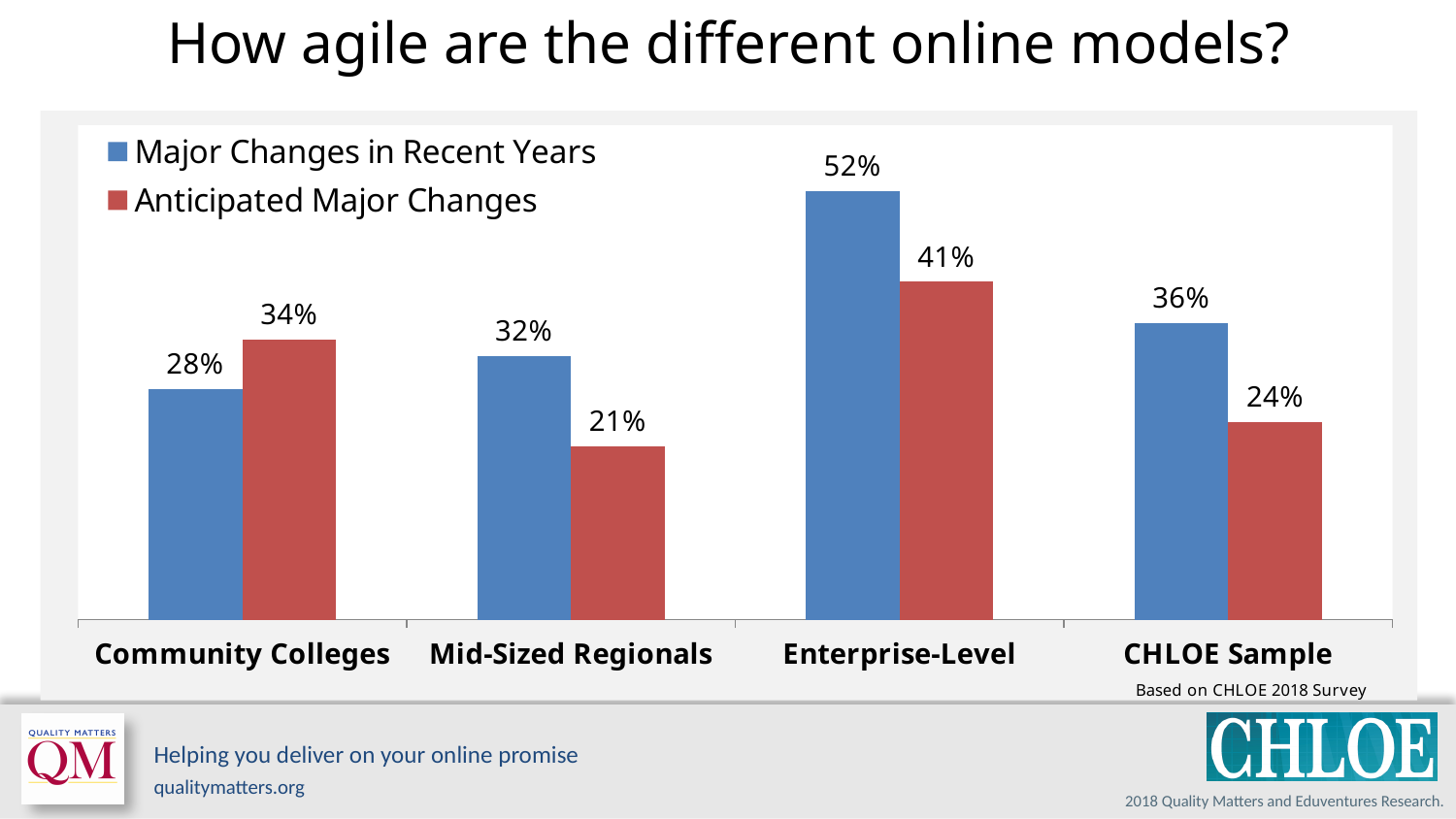
What is the value for Major Changes in Recent Years for Community Colleges? 28% How many series does the legend list? 2 Which category has the lowest value for Anticipated Major Changes? Mid-Sized Regionals What is the value for Anticipated Major Changes for Mid-Sized Regionals? 21% What is the value for Anticipated Major Changes for Enterprise-Level? 41% Which is larger for Community Colleges: Major Changes in Recent Years or Anticipated Major Changes? Anticipated Major Changes How many categories are shown on the x axis? 4 What is the value for Major Changes in Recent Years for the CHLOE Sample? 36% What is the difference between Major Changes in Recent Years and Anticipated Major Changes for Enterprise-Level? 11% What kind of chart is shown on the slide? Bar chart What colour are the bars for Anticipated Major Changes? Red Which category has the highest value for Major Changes in Recent Years? Enterprise-Level